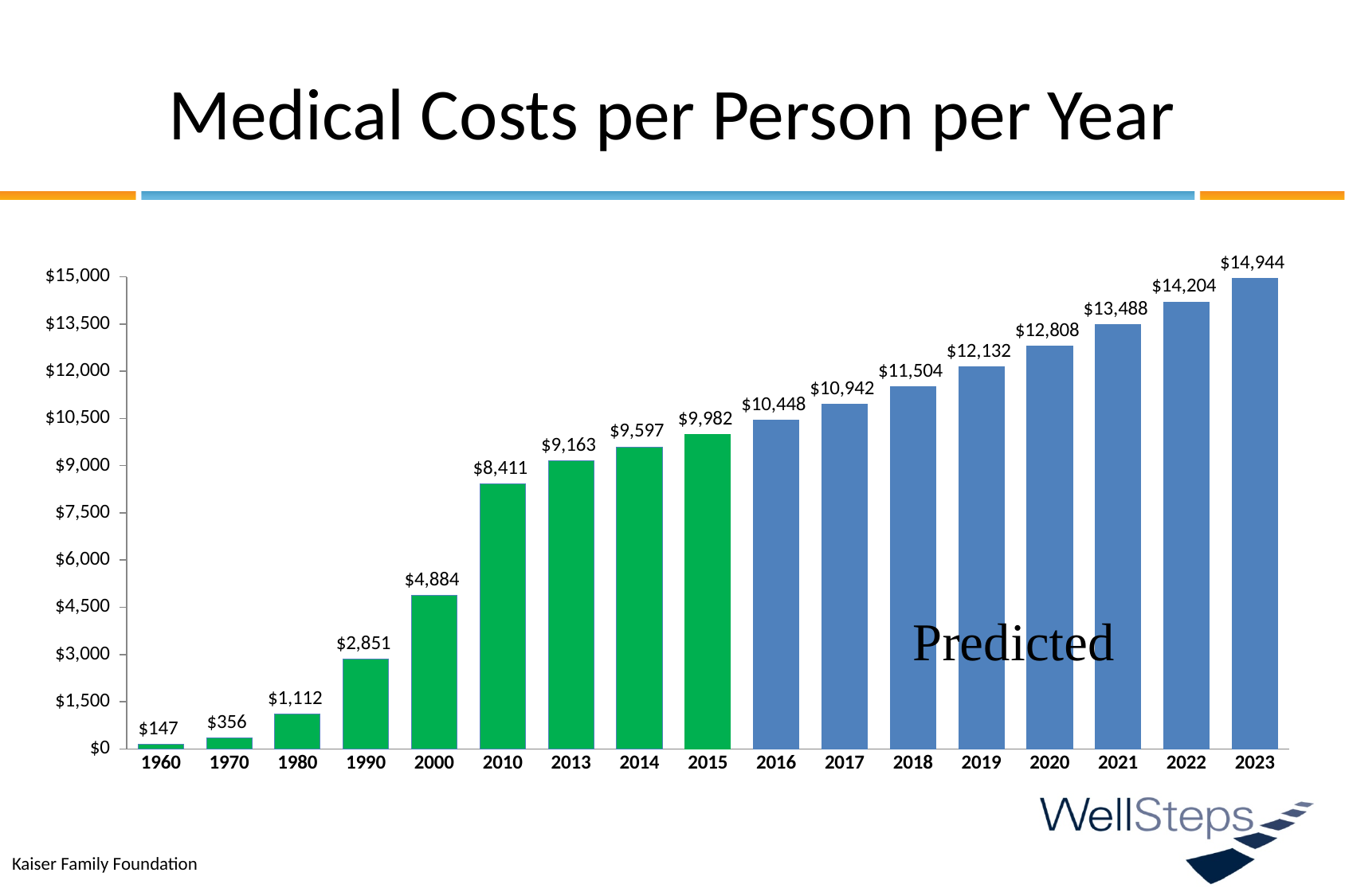
Which year has the lowest medical cost per person? 1960 What is the predicted medical cost per person for 2020? $12,808 What is the medical cost per person per year shown for 2015? $9,982 What is the difference between the values for 2023 and 2022? $740 What value is shown for 1990? $2,851 Which is larger, the value for 2013 or the value for 2016? 2016 What is the difference between the values for 2010 and 2000? $3,527 How many years are shown on the x axis? 17 What kind of chart is shown on the slide? bar chart Which year has the highest medical cost per person? 2023 Do the values rise or fall from 1960 to 2023? rise Is the value for 2018 greater or less than $12,000? less